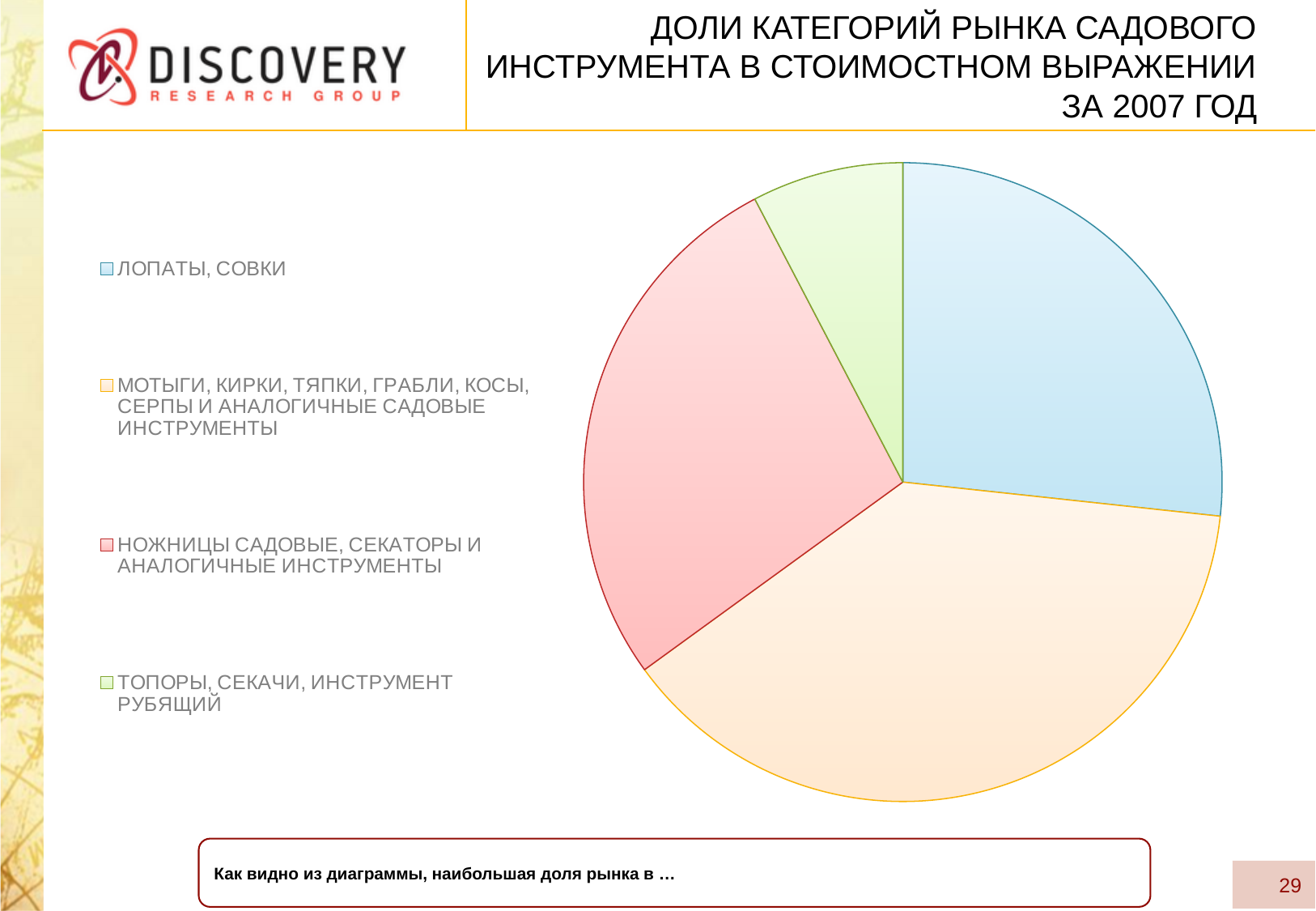
Which category has the smallest share of the pie? ТОПОРЫ, СЕКАЧИ, ИНСТРУМЕНТ РУБЯЩИЙ Which slice is larger: ТОПОРЫ, СЕКАЧИ, ИНСТРУМЕНТ РУБЯЩИЙ or НОЖНИЦЫ САДОВЫЕ, СЕКАТОРЫ И АНАЛОГИЧНЫЕ ИНСТРУМЕНТЫ? НОЖНИЦЫ САДОВЫЕ, СЕКАТОРЫ И АНАЛОГИЧНЫЕ ИНСТРУМЕНТЫ What colour is the slice for ЛОПАТЫ, СОВКИ? blue What kind of chart is shown on the slide? pie chart How many categories does the pie chart show? 4 Which category has the largest share of the pie? МОТЫГИ, КИРКИ, ТЯПКИ, ГРАБЛИ, КОСЫ, СЕРПЫ И АНАЛОГИЧНЫЕ САДОВЫЕ ИНСТРУМЕНТЫ Which slice is larger: ЛОПАТЫ, СОВКИ or ТОПОРЫ, СЕКАЧИ, ИНСТРУМЕНТ РУБЯЩИЙ? ЛОПАТЫ, СОВКИ Which slice is larger: НОЖНИЦЫ САДОВЫЕ, СЕКАТОРЫ И АНАЛОГИЧНЫЕ ИНСТРУМЕНТЫ or МОТЫГИ, КИРКИ, ТЯПКИ, ГРАБЛИ, КОСЫ, СЕРПЫ И АНАЛОГИЧНЫЕ САДОВЫЕ ИНСТРУМЕНТЫ? МОТЫГИ, КИРКИ, ТЯПКИ, ГРАБЛИ, КОСЫ, СЕРПЫ И АНАЛОГИЧНЫЕ САДОВЫЕ ИНСТРУМЕНТЫ What year does the chart title refer to? 2007 How many entries does the legend list? 4